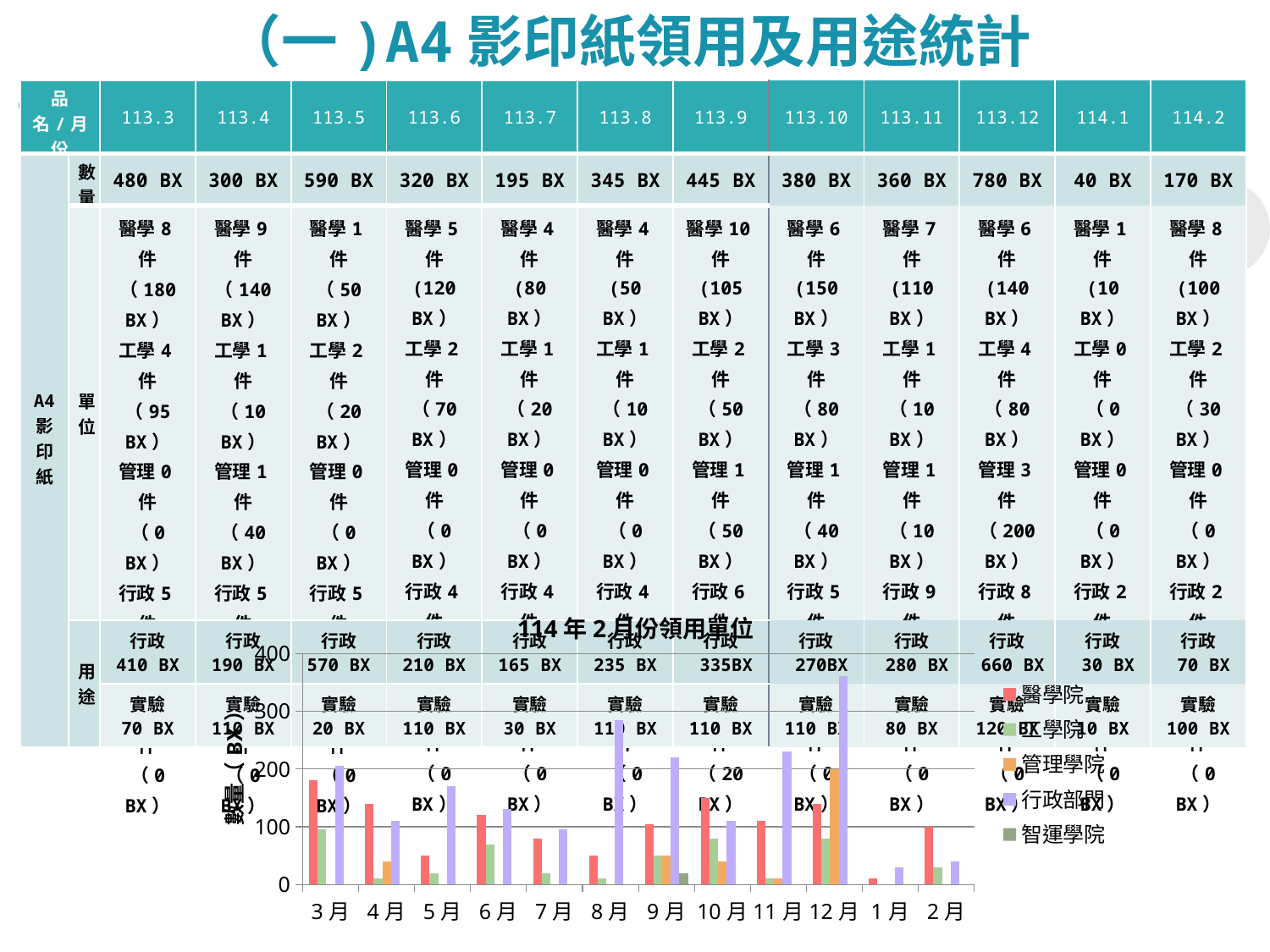
In 4月, which is larger: the 醫學院 bar or the 工學院 bar? 醫學院 What is the label of the chart's vertical axis? 數量（BX） Is the value for 行政部門 in 8月 greater or less than 200? greater How many series does the chart legend list? 5 How many month categories are shown on the chart's x axis? 12 Is the value for 醫學院 in 7月 greater or less than 100? less In which month is the 行政部門 bar highest? 12月 What is the title of the chart on the slide? 114年2月份領用單位 In which month is the 醫學院 bar lowest? 1月 Is the value for 醫學院 in 3月 greater or less than 100? greater What kind of chart is shown on the slide? bar chart